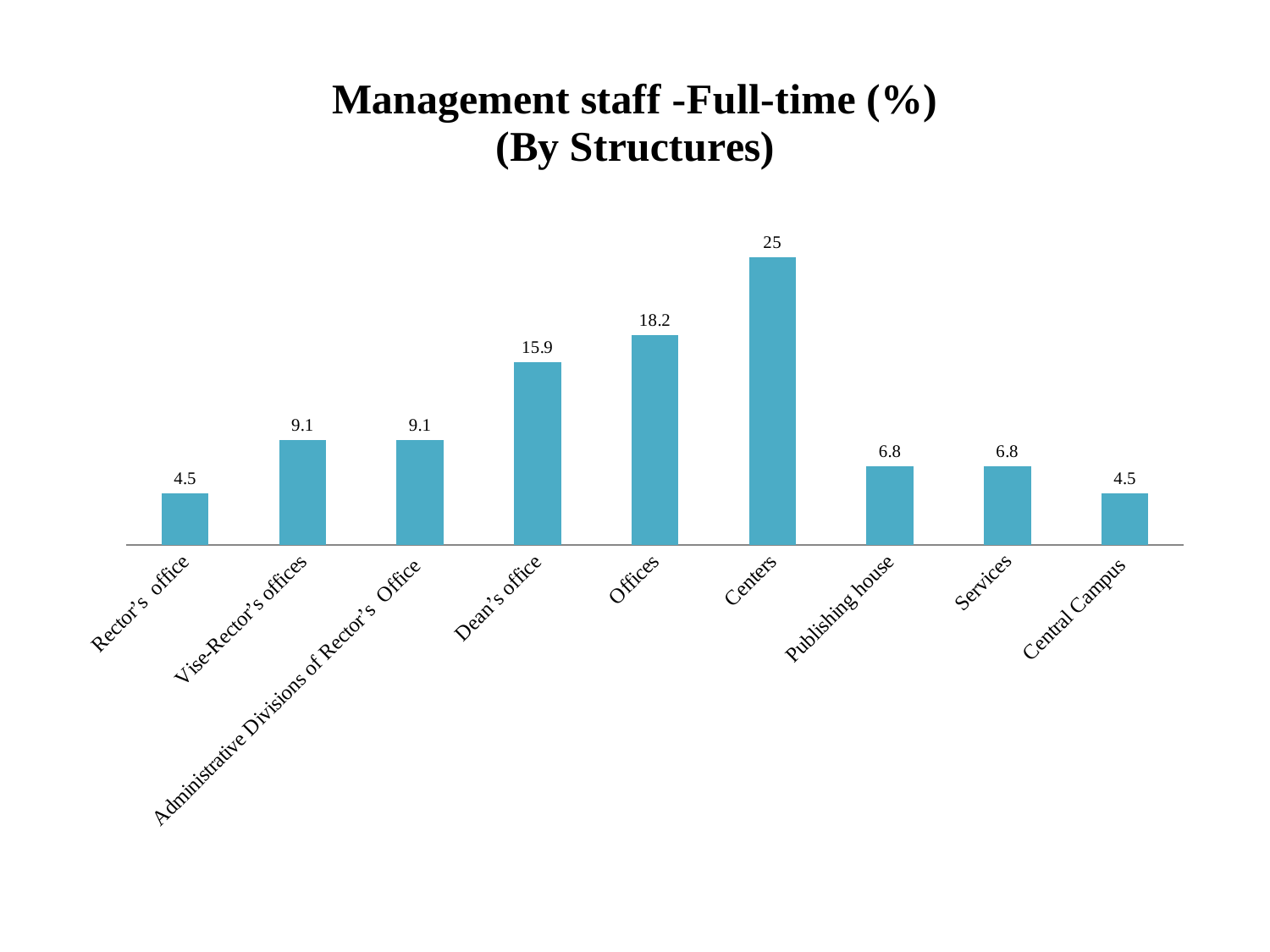
What is the value for Vise-Rector's offices? 9.1 How many categories are shown on the x axis? 9 Which is larger, the value for Offices or the value for Services? Offices What kind of chart is shown on the slide? Bar chart What is the value for Dean's office? 15.9 Which two categories share the lowest value of 4.5? Rector's office and Central Campus What is the value for Publishing house? 6.8 What is the difference between the values for Dean's office and Rector's office? 11.4 Which category has the highest value? Centers What is the difference between the values for Centers and Offices? 6.8 What is the value for Centers? 25 What is the title of the chart? Management staff -Full-time (%) (By Structures)